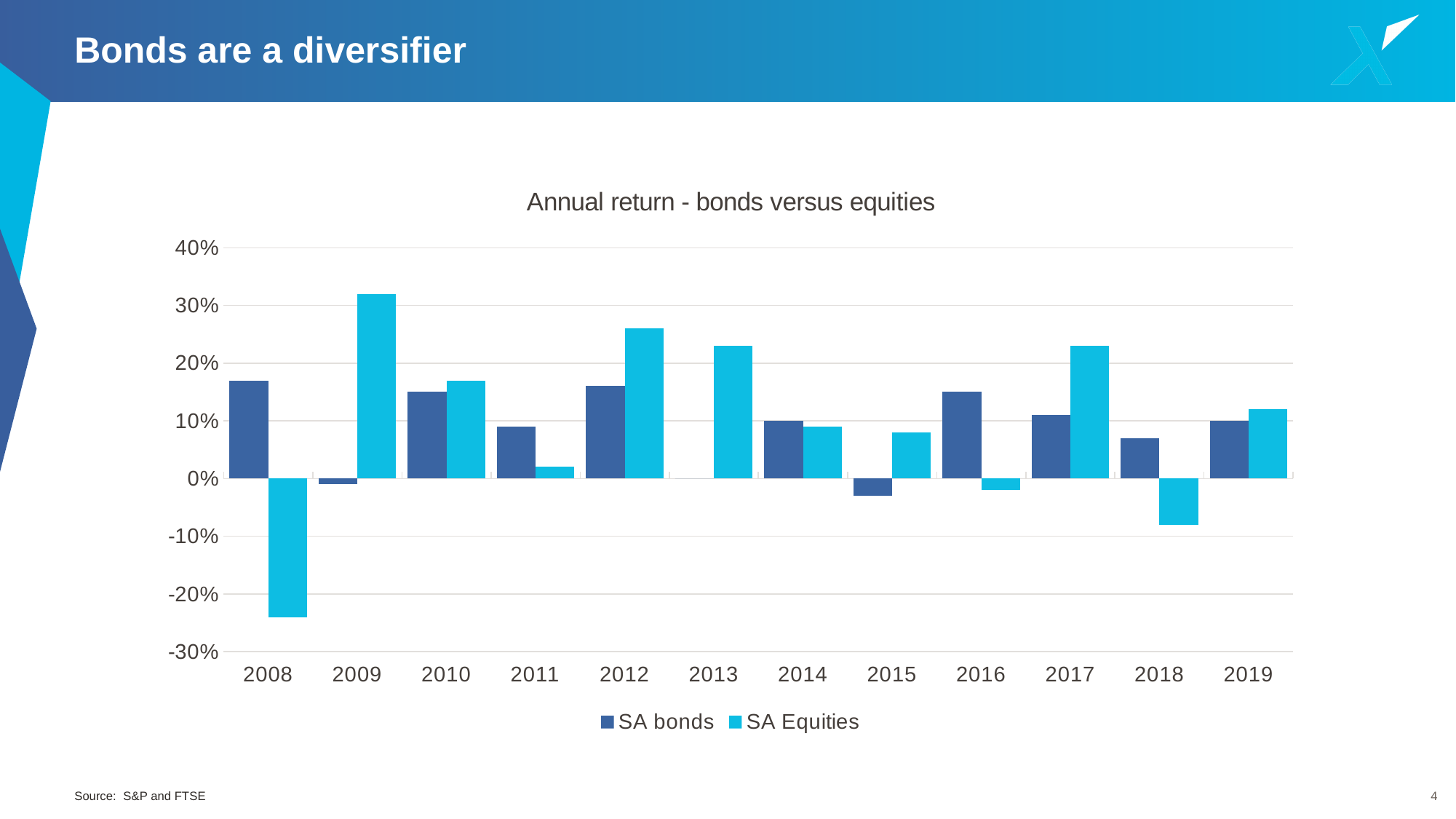
What kind of chart is shown on the slide? bar chart In which year is the SA bonds return lowest? 2015 In 2008, which is larger: the SA bonds return or the SA Equities return? SA bonds In which year is the SA Equities return lowest? 2008 Is the SA Equities value for 2009 greater or less than 30%? greater How many series does the legend list? 2 Is the SA Equities value for 2008 greater or less than -20%? less Is the SA bonds value for 2011 greater or less than 10%? less In 2009, which is larger: the SA bonds return or the SA Equities return? SA Equities In which year is the SA Equities return highest? 2009 What is the title of the chart? Annual return - bonds versus equities How many years are shown on the x axis? 12